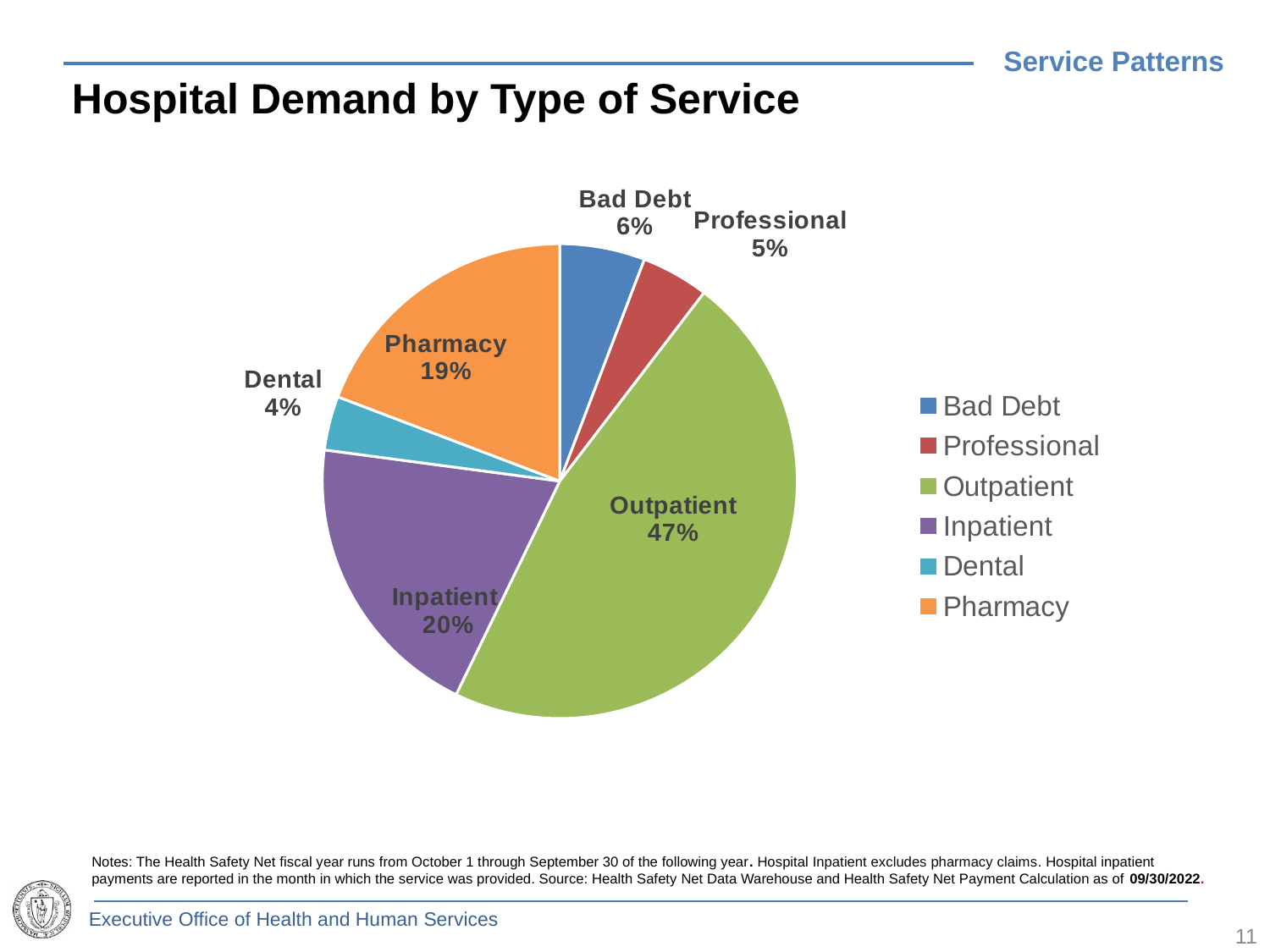
Which has a larger share, Bad Debt or Professional? Bad Debt Which type of service has the smallest share of hospital demand? Dental What is the difference in percentage points between the Outpatient and Inpatient shares? 27 What share of hospital demand is Pharmacy? 19% How many types of service are shown in the pie chart? 6 What share of hospital demand is Inpatient? 20% What is the title of the chart on the slide? Hospital Demand by Type of Service What share of hospital demand is Bad Debt? 6% Which type of service has the largest share of hospital demand? Outpatient What share of hospital demand is Outpatient? 47% What share of hospital demand is Dental? 4% What type of chart is shown on the slide? Pie chart